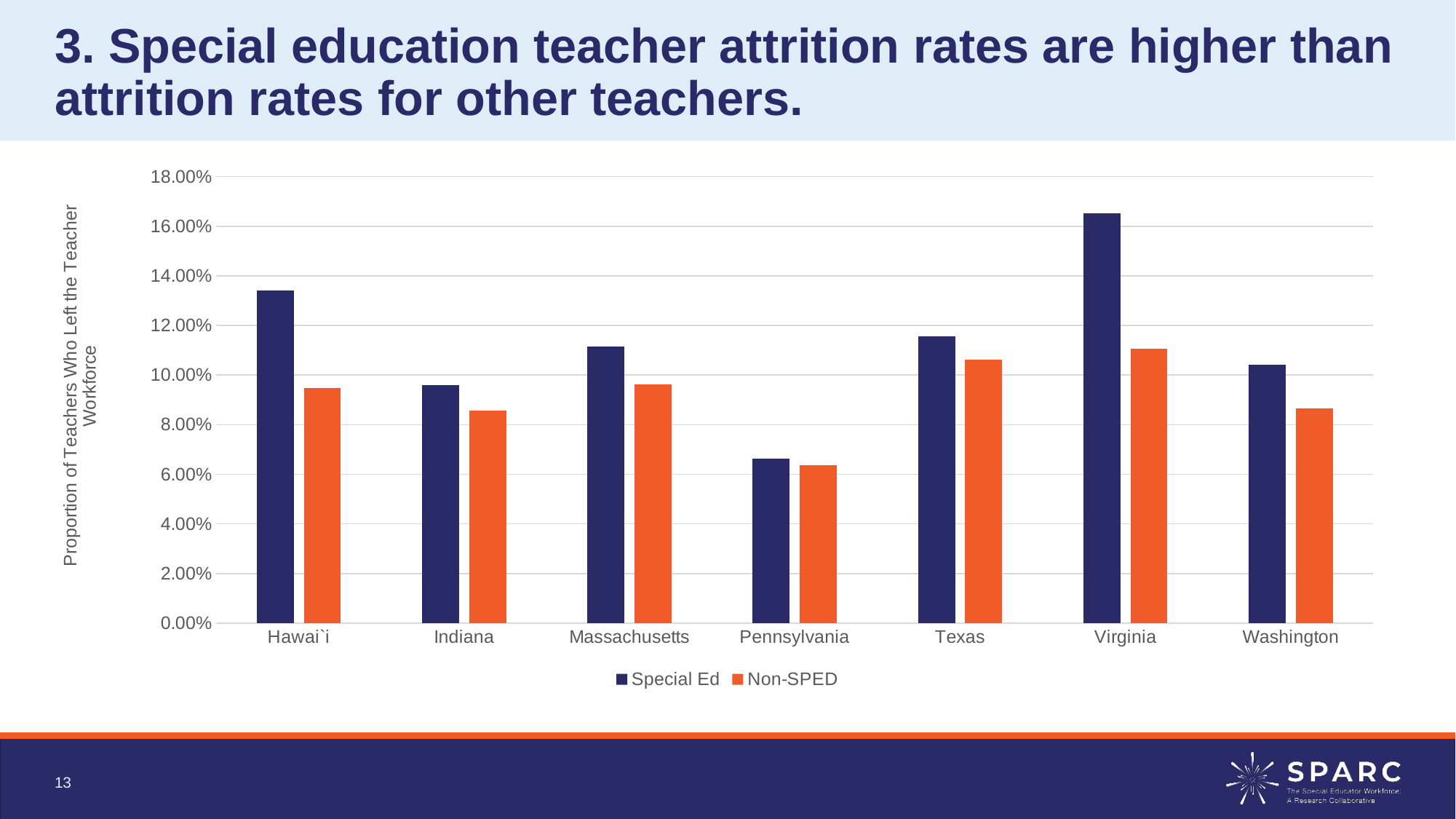
What is the title of the chart's vertical axis? Proportion of Teachers Who Left the Teacher Workforce Which state has the highest Special Ed attrition rate? Virginia Which state has the lowest Non-SPED attrition rate? Pennsylvania Is the Special Ed value for Virginia greater or less than 16.00%? greater What kind of chart is shown on the slide? Bar chart Is the Special Ed value for Hawai`i greater or less than 12.00%? greater How many states are shown on the x axis of the chart? 7 Is the Non-SPED value for Washington greater or less than 10.00%? less How many series does the chart's legend list? 2 In Hawai`i, which is larger: the Special Ed rate or the Non-SPED rate? Special Ed Which state has the lowest Special Ed attrition rate? Pennsylvania